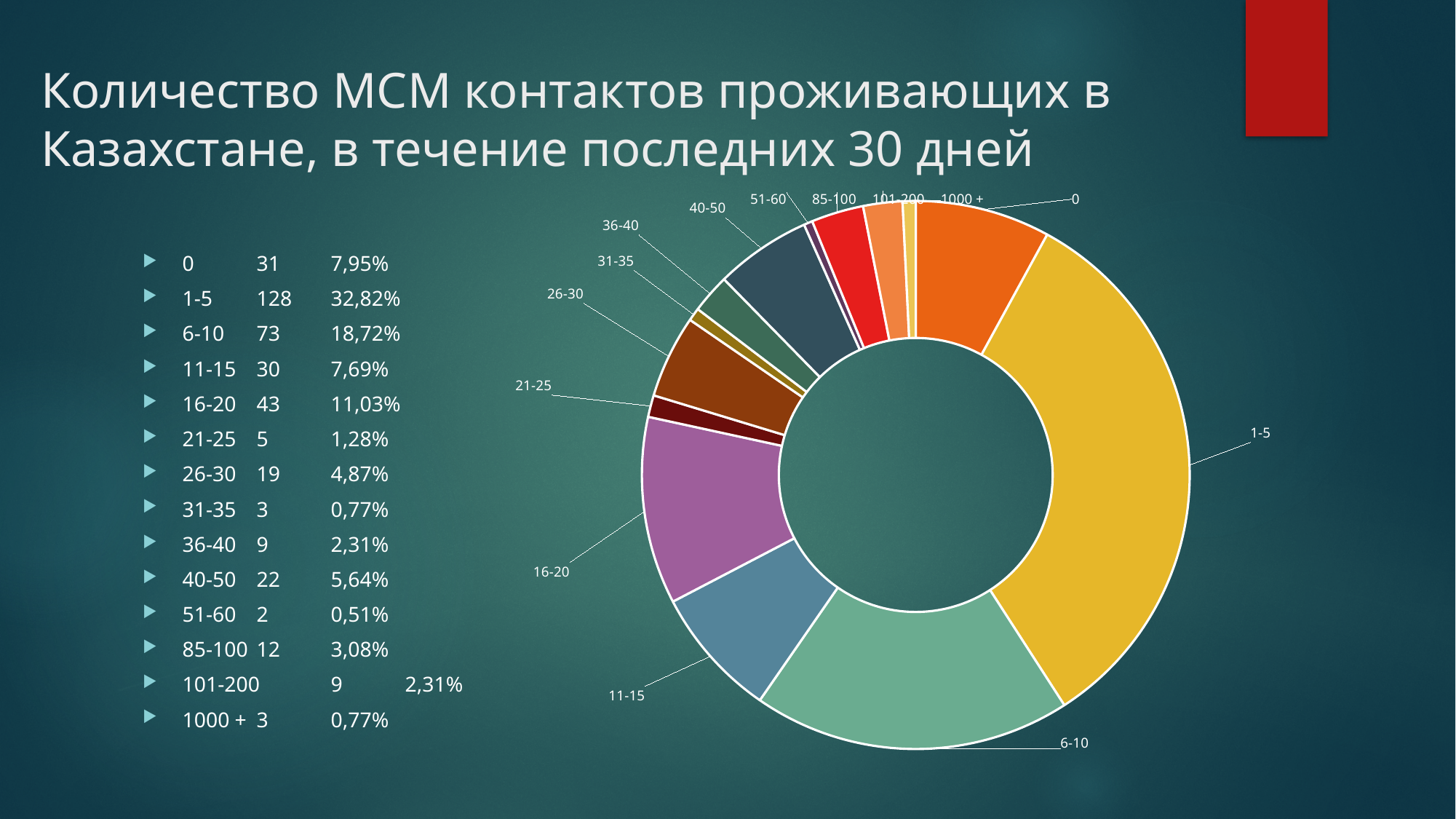
How many categories (slices) does the chart have? 14 What share of the chart does the 1-5 category represent? 32,82% What colour is the 1-5 slice in the chart? yellow Which category has the largest slice in the chart? 1-5 What is the difference between the counts for 1-5 and 6-10? 55 Which is larger, the slice for 16-20 or the slice for 11-15? 16-20 What is the count for the 0 category? 31 Which category has the smallest slice in the chart? 51-60 What kind of chart is shown on the slide? doughnut chart What percentage is shown for the 40-50 category? 5,64% What is the count for the 16-20 category? 43 What share of the chart does the 6-10 category represent? 18,72%